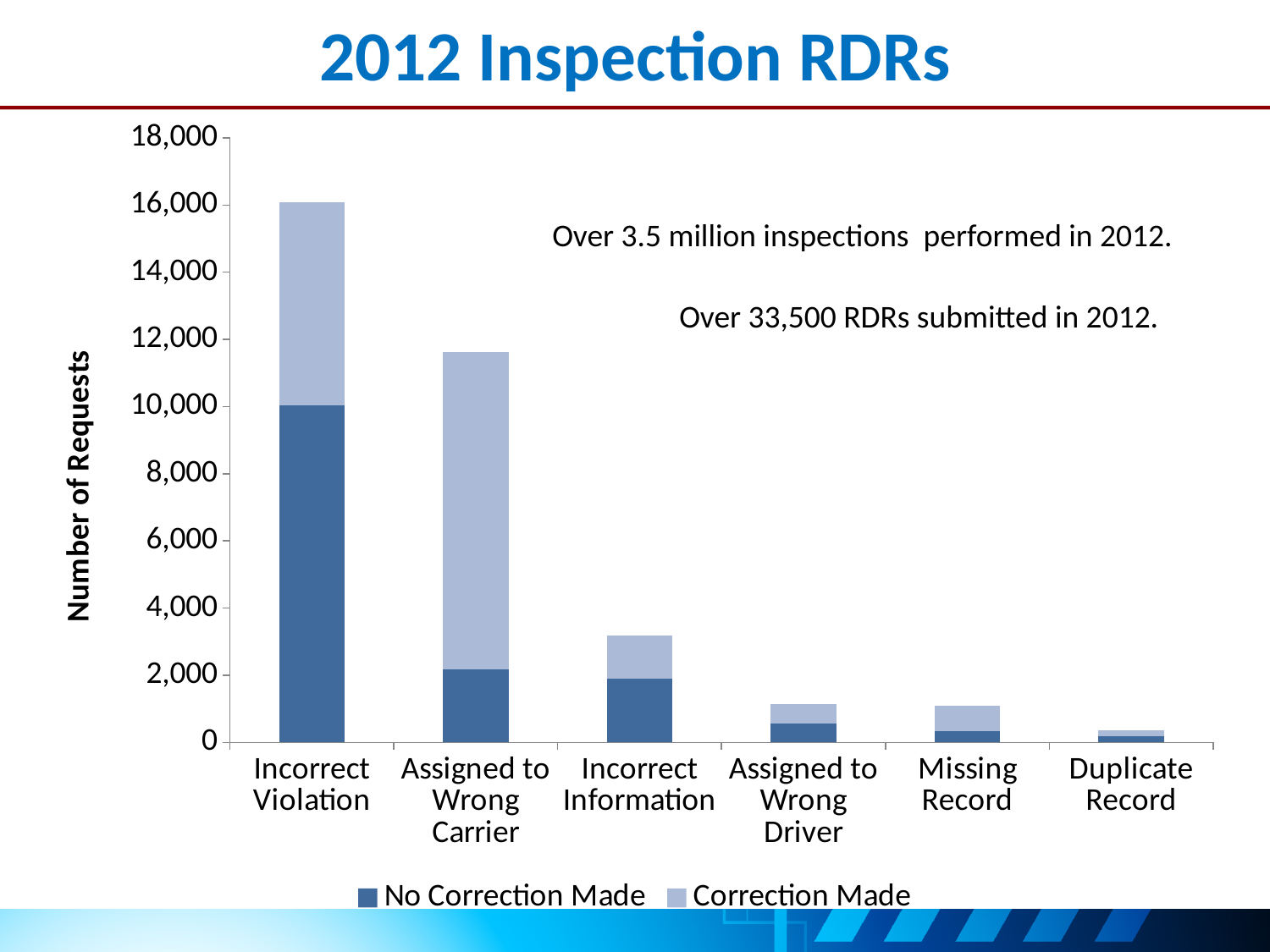
How many series does the chart's legend list? 2 How many categories are shown on the x axis of the chart? 6 Which category has the lowest total number of requests? Duplicate Record Which category has the highest total number of requests? Incorrect Violation What is the title of the chart's vertical axis? Number of Requests Is the total value for Incorrect Information greater or less than 2,000? greater Is the total value for Assigned to Wrong Carrier greater or less than 12,000? less Is the total value for Incorrect Violation greater or less than 14,000? greater Which has a larger total number of requests: Assigned to Wrong Carrier or Incorrect Information? Assigned to Wrong Carrier What kind of chart is shown on the slide? Stacked bar chart What are the two series named in the chart's legend? No Correction Made and Correction Made